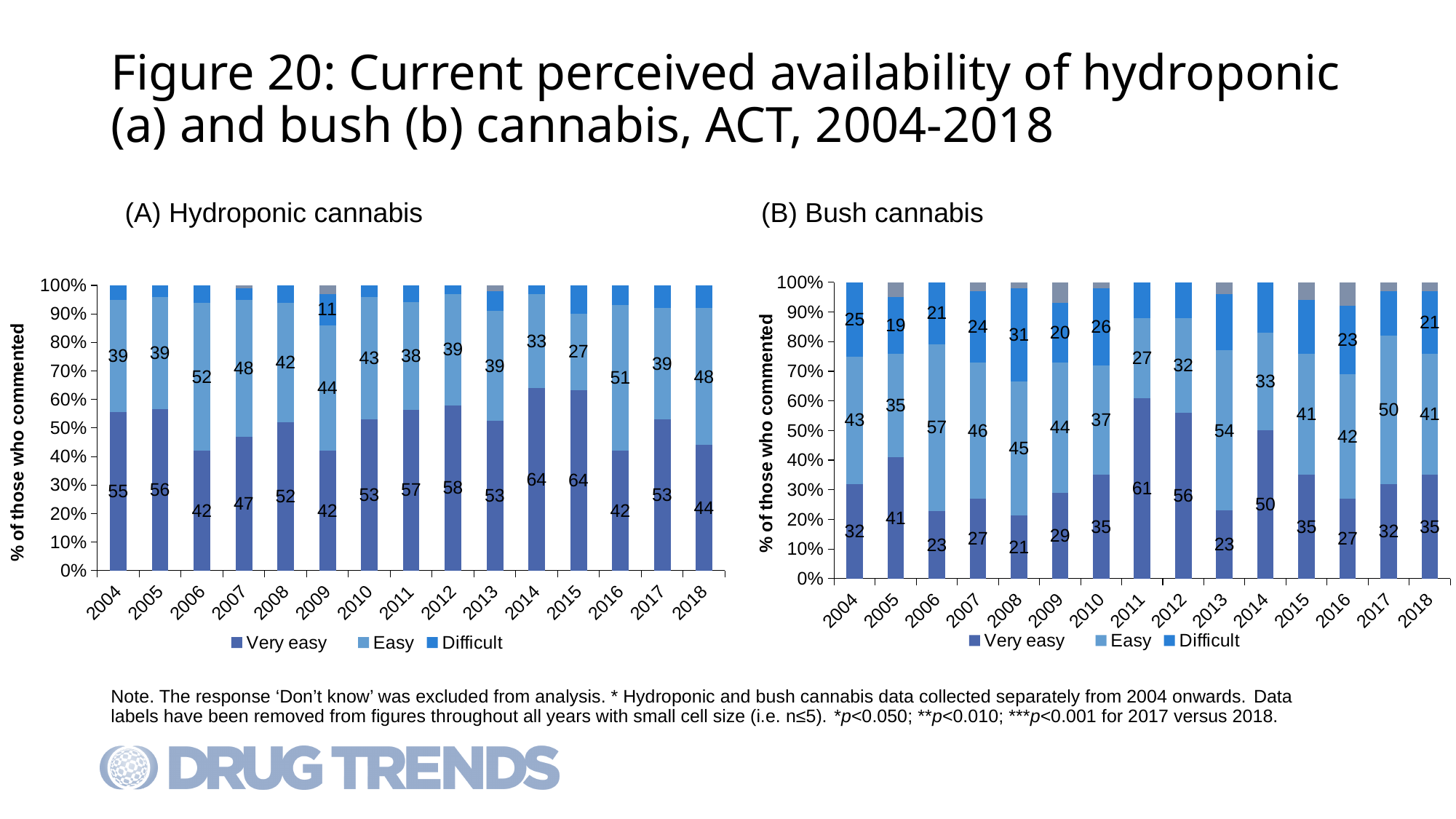
What kind of chart is the (A) Hydroponic cannabis chart? Stacked bar chart In the (A) Hydroponic cannabis chart, which is larger: the 'Very easy' value for 2007 or for 2008? 2008 In the (B) Bush cannabis chart, what is the 'Easy' value for 2006? 57 In the (B) Bush cannabis chart, what is the difference between the 'Easy' values for 2013 and 2014? 21 How many series does the legend of the (A) Hydroponic cannabis chart list? 3 In the (A) Hydroponic cannabis chart, what is the difference between the 'Very easy' values for 2012 and 2018? 14 In the (B) Bush cannabis chart, which year has the highest 'Very easy' value? 2011 In the (A) Hydroponic cannabis chart, which year has the lowest 'Easy' value? 2015 In the (B) Bush cannabis chart, which year has the lowest 'Very easy' value? 2008 In the (B) Bush cannabis chart, what is the 'Difficult' value for 2008? 31 How many years are shown on the x axis of the (B) Bush cannabis chart? 15 In the (A) Hydroponic cannabis chart, what percentage of respondents said 'Very easy' in 2014? 64